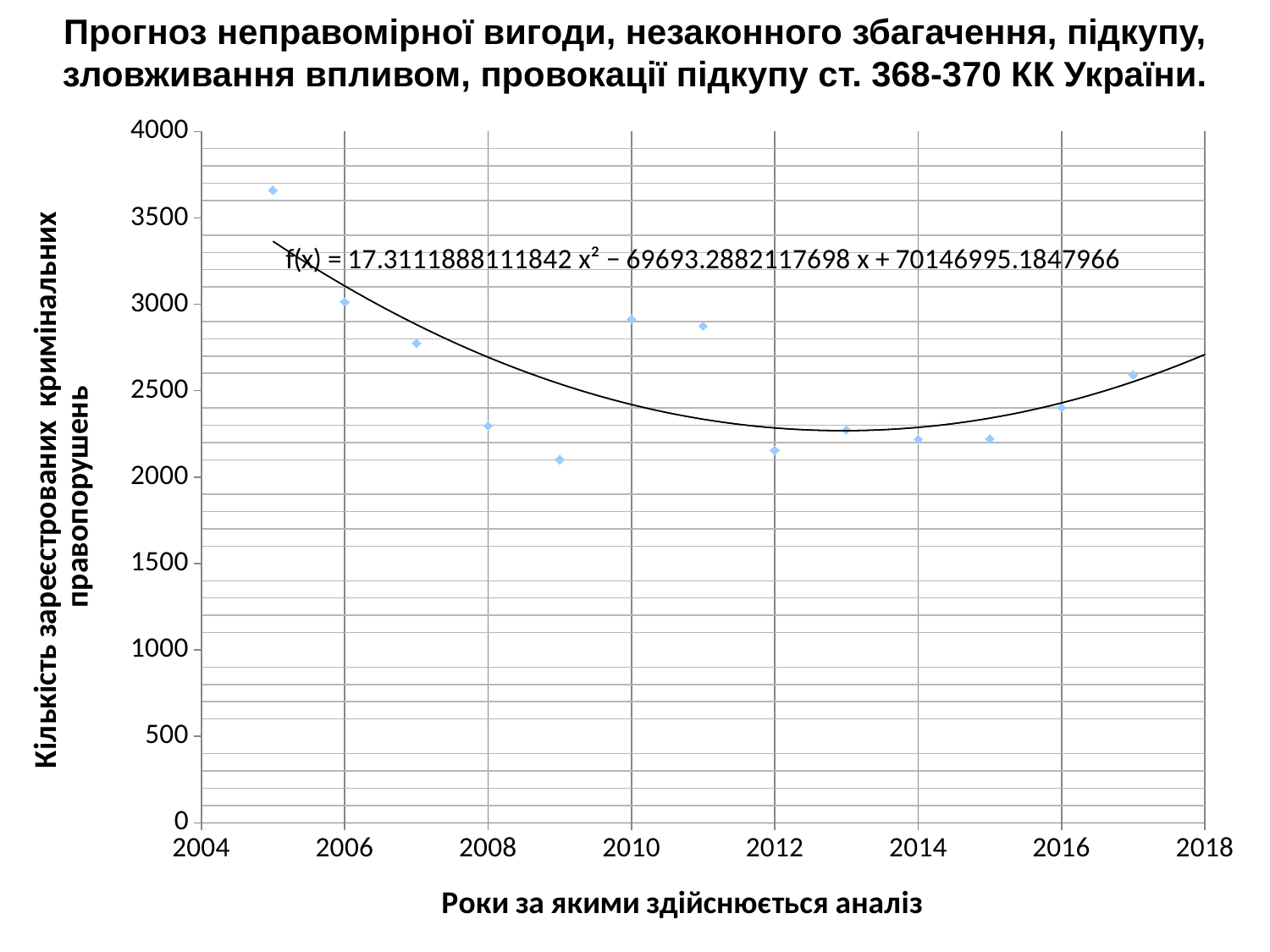
What kind of chart is shown on the slide? scatter chart Is the value for 2012 greater or less than 2500? less Which is larger, the value for 2005 or the value for 2017? 2005 Is the value for 2005 greater or less than 3500? greater Which year has the highest number of registered criminal offences? 2005 How many data points are plotted on the chart? 13 Do the plotted values rise or fall from 2005 to 2009? fall Which is larger, the value for 2010 or the value for 2012? 2010 Is the value for 2008 greater or less than 2500? less What is the title of the x axis? Роки за якими здійснюється аналіз